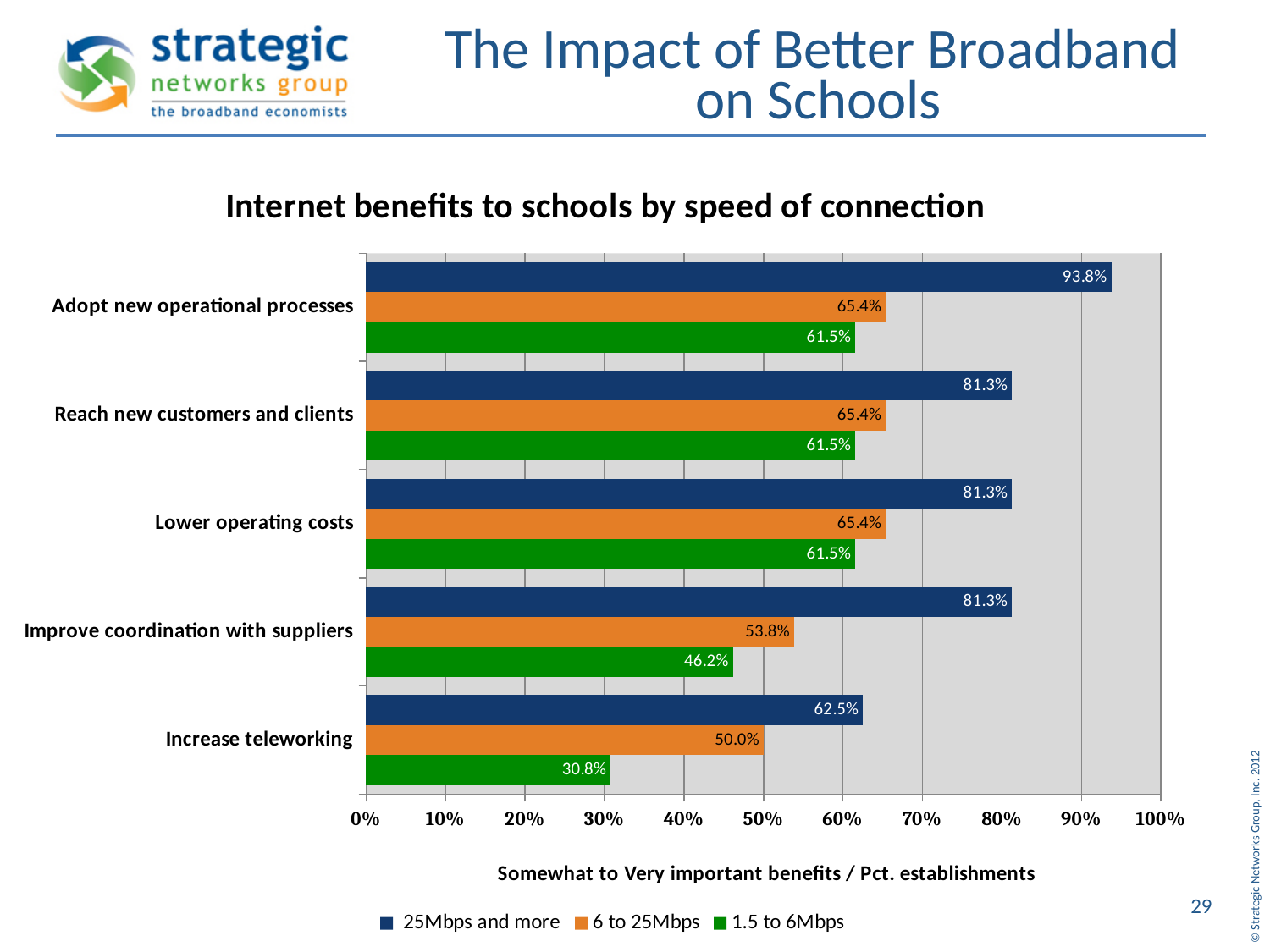
What is the difference between the '25Mbps and more' and '1.5 to 6Mbps' values for 'Increase teleworking'? 31.7% What is the value for '6 to 25Mbps' for 'Improve coordination with suppliers'? 53.8% What is the value for '25Mbps and more' for 'Adopt new operational processes'? 93.8% For 'Improve coordination with suppliers', which is larger: the '6 to 25Mbps' value or the '1.5 to 6Mbps' value? 6 to 25Mbps Which category has the highest value for the '25Mbps and more' series? Adopt new operational processes What is the title of the chart? Internet benefits to schools by speed of connection What is the value for '1.5 to 6Mbps' for 'Increase teleworking'? 30.8% How many categories are shown on the chart? 5 What is the x-axis label of the chart? Somewhat to Very important benefits / Pct. establishments What kind of chart is shown on the slide? Bar chart Which category has the lowest value for the '1.5 to 6Mbps' series? Increase teleworking How many series does the legend list? 3